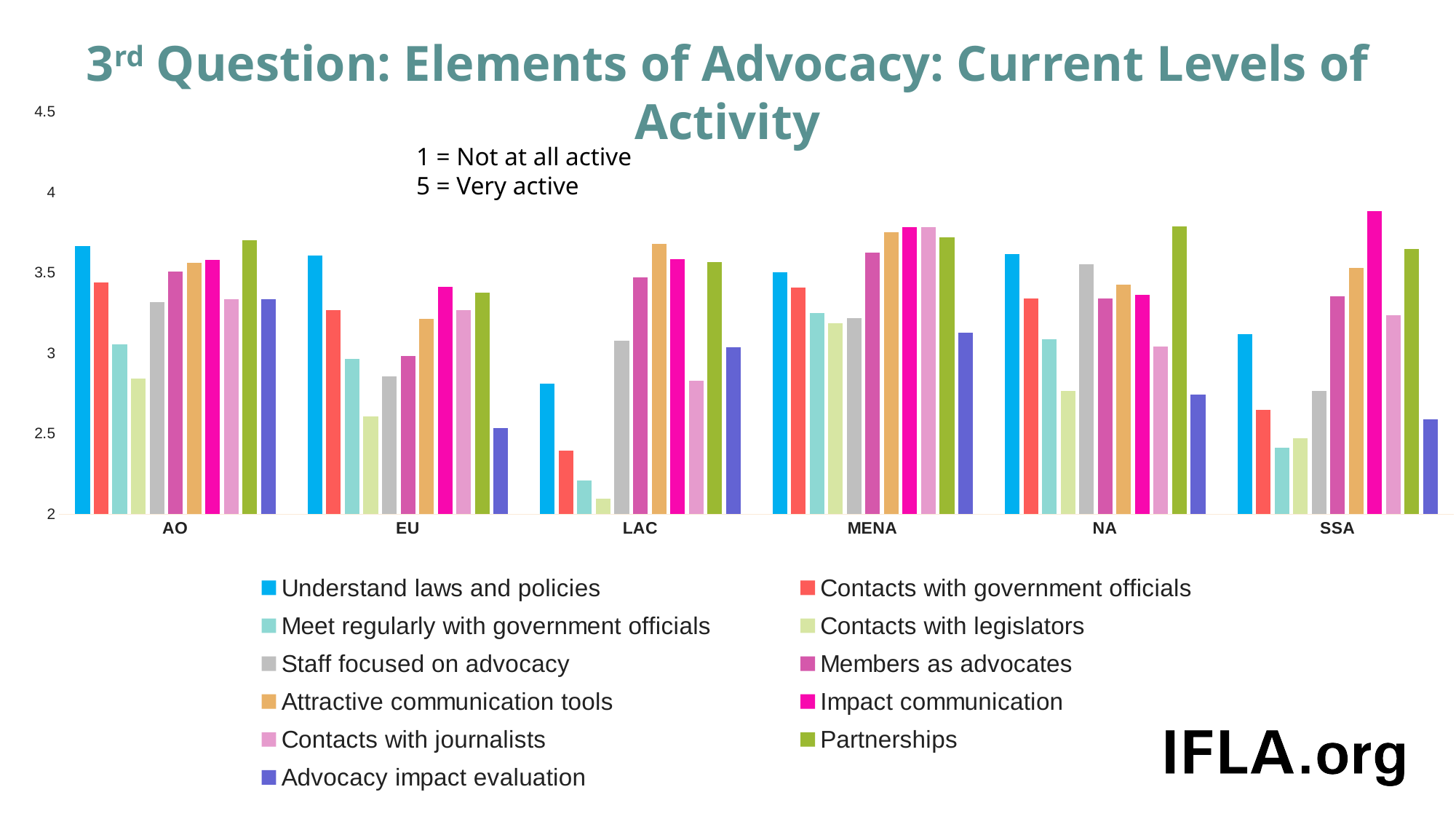
How many series does the legend list? 11 Is the value for Understand laws and policies larger in AO or in LAC? AO Which series has the lowest value in LAC? Contacts with legislators Which series has the highest value in SSA? Impact communication Is the value for Partnerships in NA greater or less than 3.5? greater How many regions are shown along the x axis? 6 Is the value for Impact communication in SSA greater or less than 3.5? greater Is the value for Contacts with legislators in LAC greater or less than 2.5? less What kind of chart is shown on the slide? bar chart Which series has the lowest value in AO? Contacts with legislators According to the note on the slide, what does a score of 5 mean? Very active